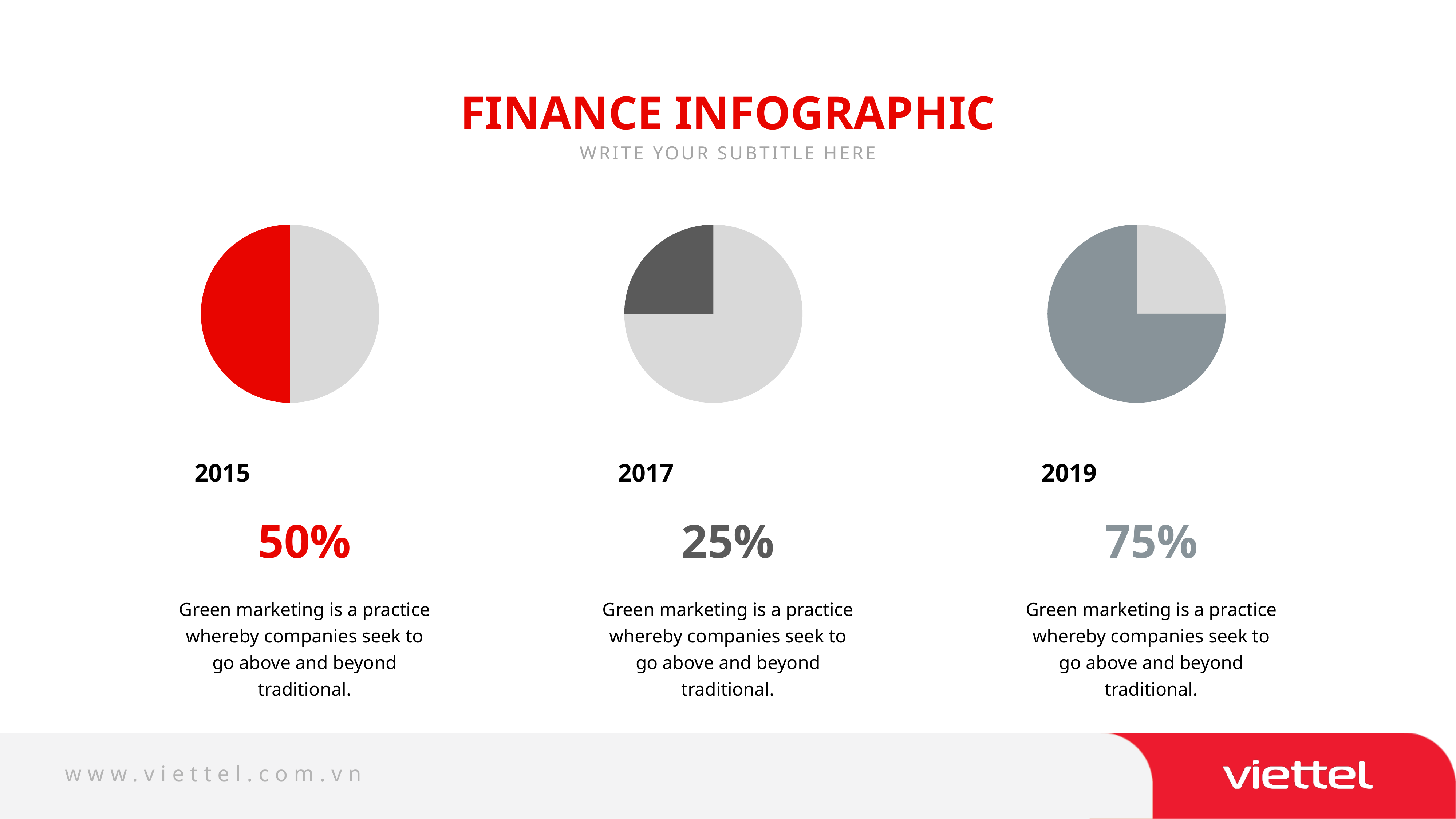
What colour is the filled slice of the 2015 pie chart? red How many pie charts are shown on the slide? 3 Which year's pie chart shows the highest percentage? 2019 What percentage is shown for the 2019 pie chart? 75% What percentage is shown for the 2017 pie chart? 25% Which is larger, the percentage for 2015 or the percentage for 2019? 2019 What is the difference between the percentage shown for 2015 and the percentage shown for 2017? 25% What is the difference between the percentage shown for 2019 and the percentage shown for 2017? 50% Which year's pie chart shows the lowest percentage? 2017 What kind of chart is used for the 2015 figure on the slide? pie chart What percentage is shown for the 2015 pie chart? 50% What share of the 2017 pie chart is filled by the dark grey slice? 25%